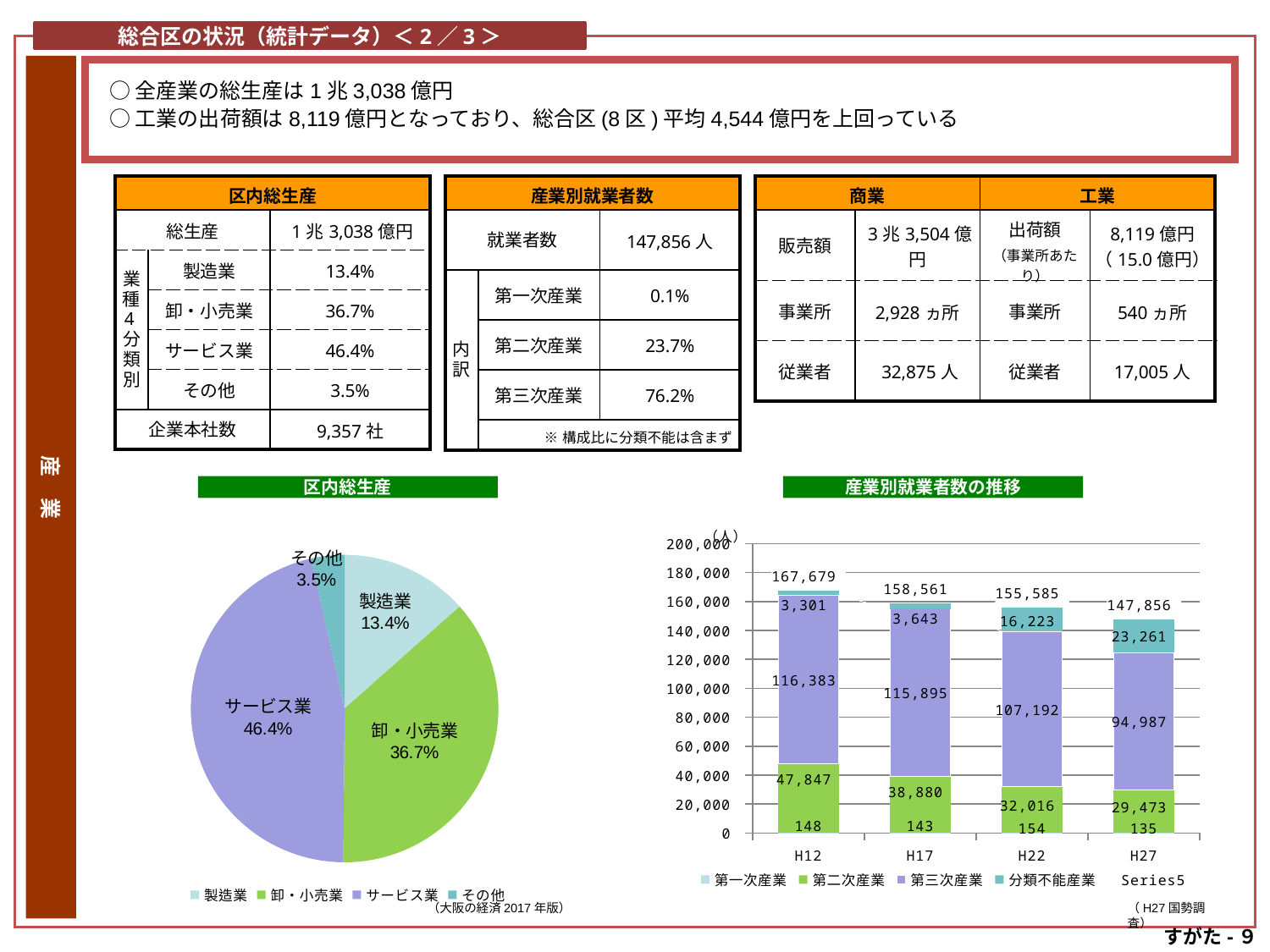
In the pie chart titled 区内総生産, how many slices are there? 4 What kind of chart is the chart titled 産業別就業者数の推移? Stacked bar chart In the bar chart titled 産業別就業者数の推移, what is the total for H27? 147,856 In the pie chart titled 区内総生産, what is the share for サービス業? 46.4% In the pie chart titled 区内総生産, what is the difference between the shares of 卸・小売業 and 製造業? 23.3% In the bar chart titled 産業別就業者数の推移, what is the difference between the 第二次産業 values for H12 and H27? 18,374 In the bar chart titled 産業別就業者数の推移, is the 分類不能産業 value larger in H22 or H27? H27 In the pie chart titled 区内総生産, which category has the largest share? サービス業 In the bar chart titled 産業別就業者数の推移, what is the value for 第三次産業 in H22? 107,192 In the pie chart titled 区内総生産, which category has the smallest share? その他 In the bar chart titled 産業別就業者数の推移, which year has the highest total? H12 In the bar chart titled 産業別就業者数の推移, do the totals rise or fall from H12 to H27? Fall